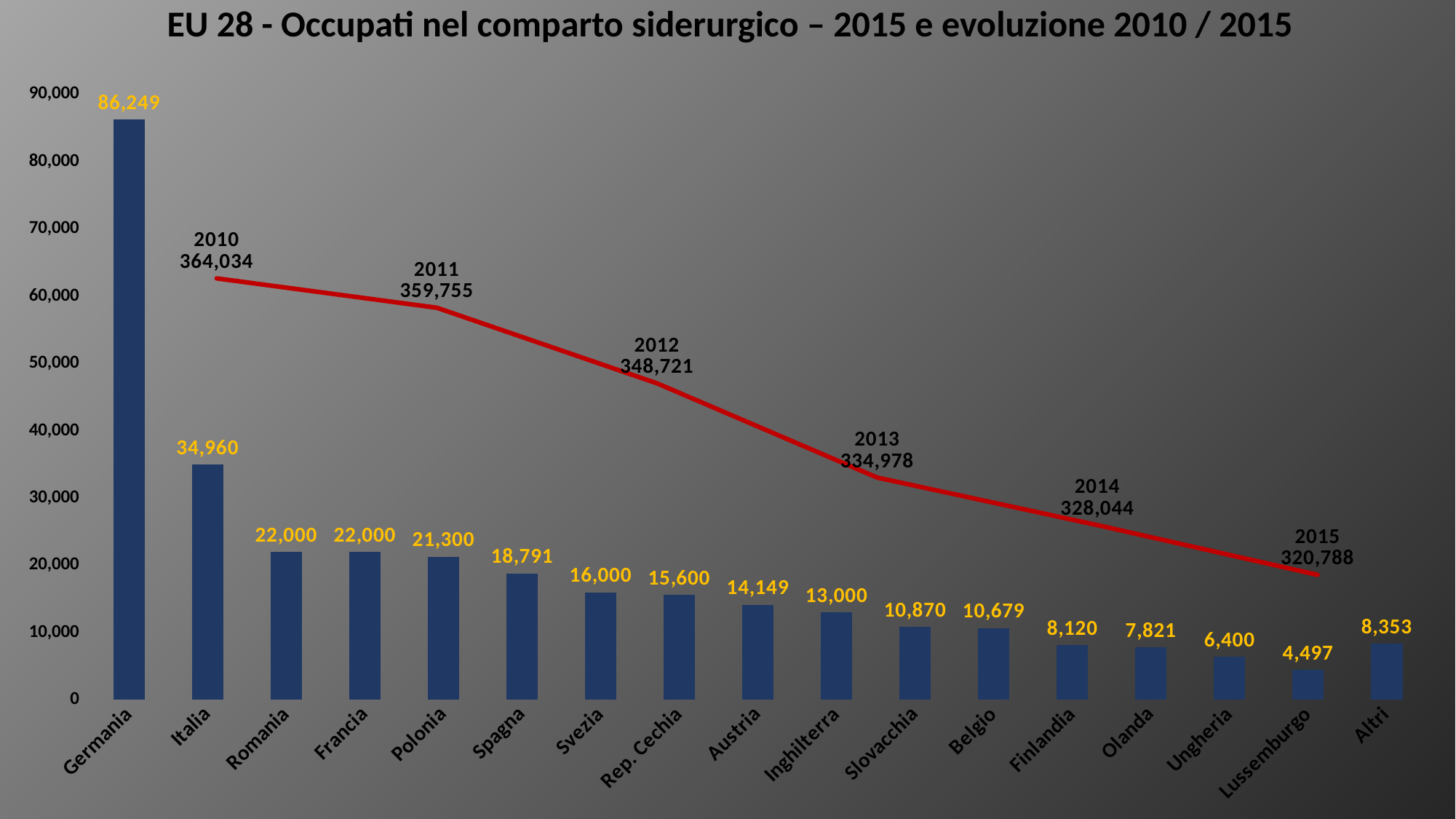
What is the value shown for Spagna? 18,791 What value does the red line show for 2013? 334,978 Which country has the highest bar? Germania Which country has the lowest bar? Lussemburgo What is the difference between the red line's 2010 value and its 2015 value? 43,246 How many data points does the red line have? 6 Does the red line rise or fall from 2010 to 2015? Fall What is the value shown for Germania? 86,249 Which is larger, the value for Belgio or the value for Finlandia? Belgio What is the difference between the values for Germania and Italia? 51,289 What is the title of the chart? EU 28 - Occupati nel comparto siderurgico – 2015 e evoluzione 2010 / 2015 How many countries/categories are shown as bars? 17